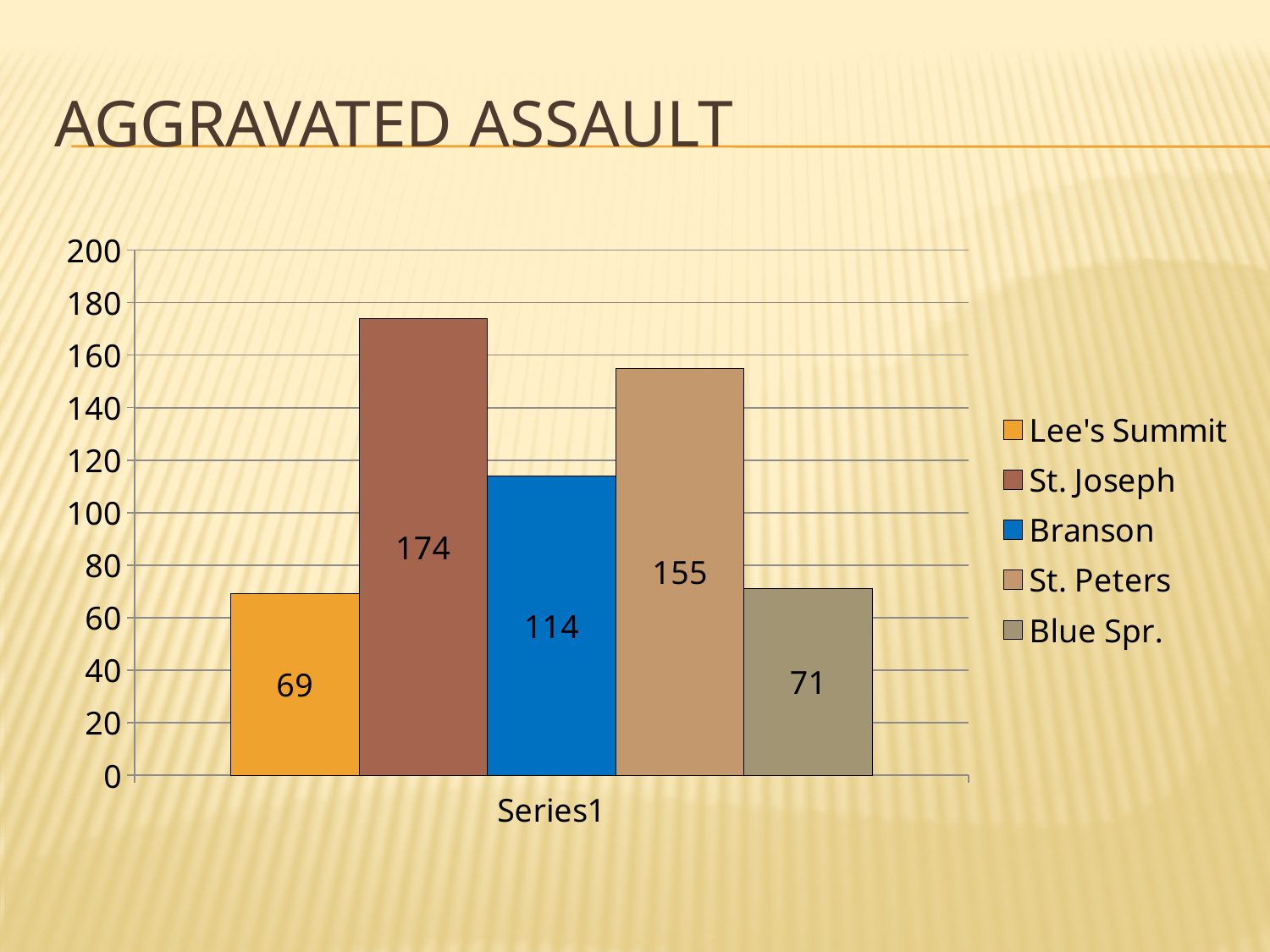
What kind of chart is shown on the slide? bar chart How many bars are shown in the chart? 5 Is the value for St. Joseph greater or less than 160? greater What is the title of the slide? AGGRAVATED ASSAULT What is the value for Blue Spr.? 71 What is the value for Branson? 114 Which is larger, the value for St. Peters or the value for Branson? St. Peters Which city has the highest value? St. Joseph What is the value for St. Joseph? 174 What is the difference between the values for Branson and Lee's Summit? 45 What is the difference between the values for St. Joseph and St. Peters? 19 Which city has the lowest value? Lee's Summit